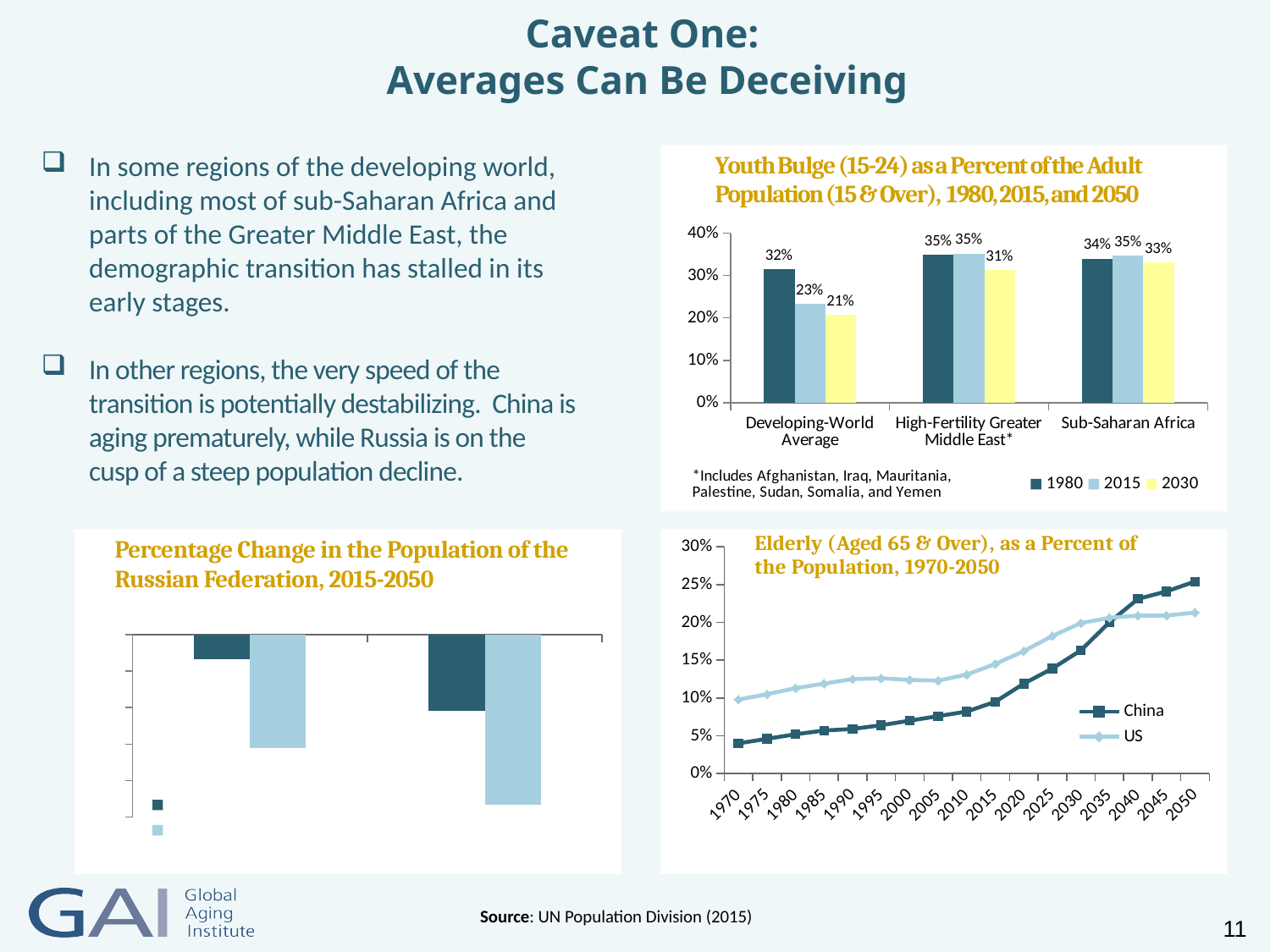
In the Youth Bulge chart, what is the value for Developing-World Average in 1980? 32% In the Youth Bulge chart, what is the difference between the 1980 and 2030 values for Developing-World Average? 11 percentage points In the Youth Bulge chart, which is larger: the 2030 value for High-Fertility Greater Middle East or the 2030 value for Sub-Saharan Africa? Sub-Saharan Africa In the Elderly (Aged 65 & Over) chart, is the value for China in 1970 greater or less than 5%? less In the Elderly (Aged 65 & Over) chart, does the China series rise or fall from 1970 to 2050? Rise In the Elderly (Aged 65 & Over) chart, is the value for China in 2050 greater or less than 20%? greater In the Youth Bulge chart, what is the value for Sub-Saharan Africa in 2030? 33% What kind of chart is the Elderly (Aged 65 & Over) chart? Line chart In the Youth Bulge chart, which category has the lowest value for 2030? Developing-World Average How many series does the legend of the Youth Bulge chart list? 3 In the Youth Bulge chart, what is the value for High-Fertility Greater Middle East in 2015? 35% How many categories are shown on the x axis of the Youth Bulge chart? 3